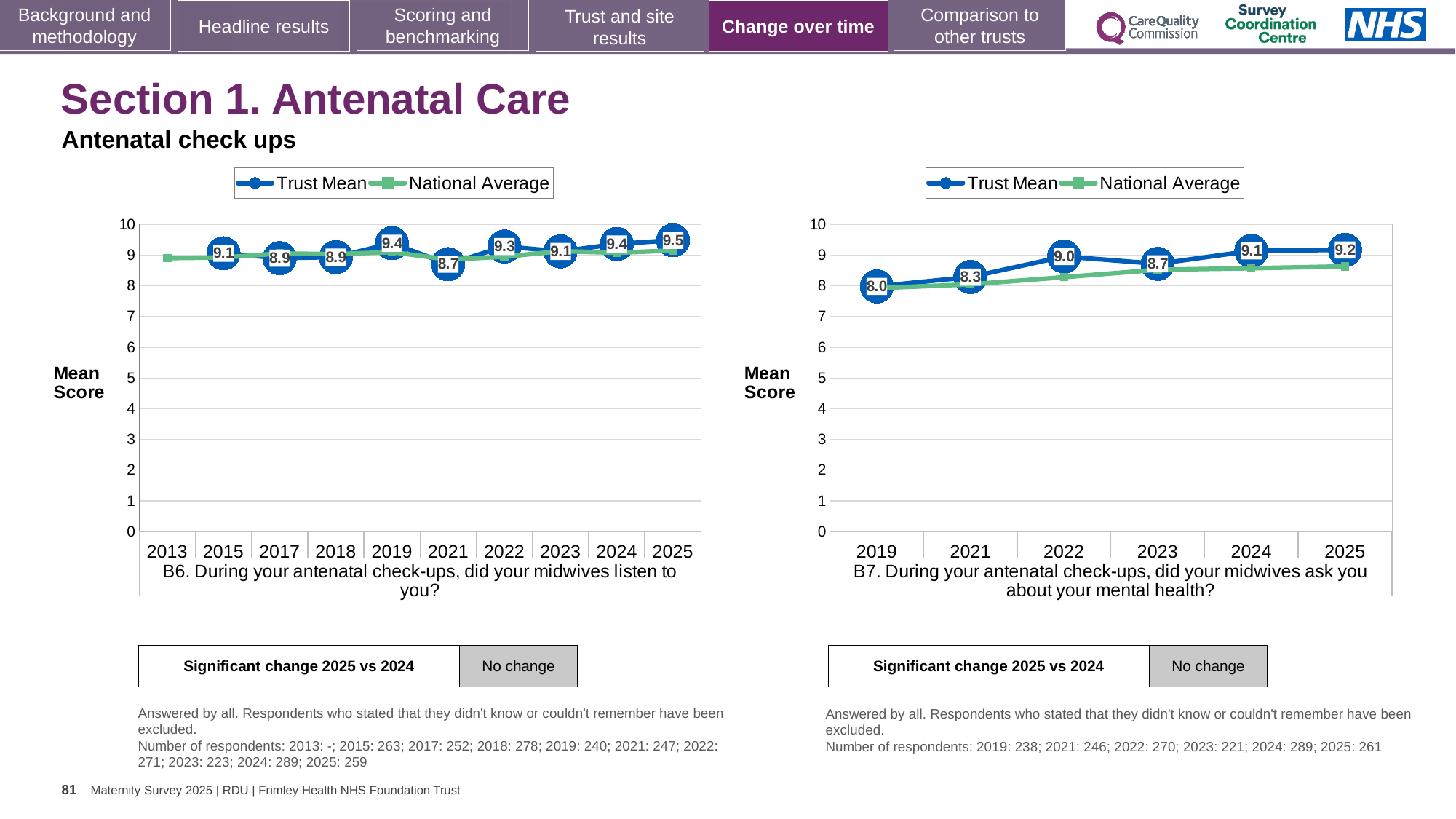
In the B6 chart on the left, what is the Trust Mean score for 2025? 9.5 In the B6 chart on the left, what is the difference between the Trust Mean scores for 2025 and 2021? 0.8 In the B6 chart on the left, is the Trust Mean score higher in 2019 or in 2021? 2019 In the B7 chart on the right, which year has the highest Trust Mean score? 2025 In the B7 chart on the right, does the Trust Mean score overall rise or fall from 2019 to 2025? Rise In the B7 chart on the right, what is the Trust Mean score for 2019? 8.0 In the B7 chart on the right, is the National Average value for 2019 greater or less than 9? less How many series does the legend of the B6 chart on the left list? 2 How many years are shown on the x axis of the B7 chart on the right? 6 In the B7 chart on the right, what is the difference between the Trust Mean scores for 2025 and 2019? 1.2 In the B6 chart on the left, which year has the lowest Trust Mean score? 2021 What type of chart is the B7 chart on the right? Line chart